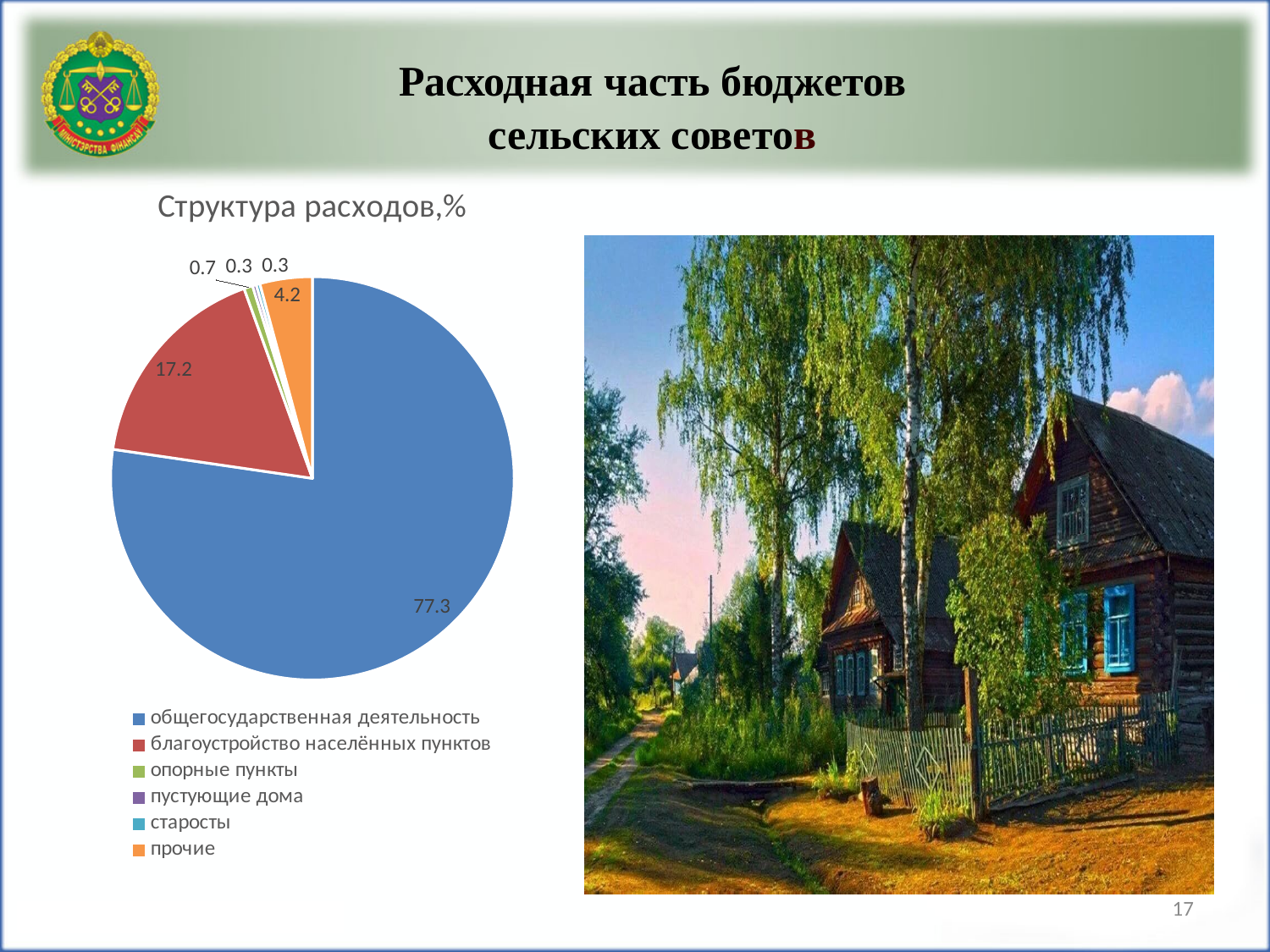
What is the title of the chart? Структура расходов,% What colour is the slice for общегосударственная деятельность? blue Which category has the largest share of the pie? общегосударственная деятельность What is the value for благоустройство населённых пунктов? 17.2 How many categories does the legend list? 6 What is the value for прочие? 4.2 What is the difference between the values for общегосударственная деятельность and благоустройство населённых пунктов? 60.1 Which is larger, the value for прочие or the value for благоустройство населённых пунктов? благоустройство населённых пунктов What is the value for опорные пункты? 0.7 What is the difference between the values for прочие and опорные пункты? 3.5 What is the value for общегосударственная деятельность? 77.3 What type of chart is shown on the slide? pie chart